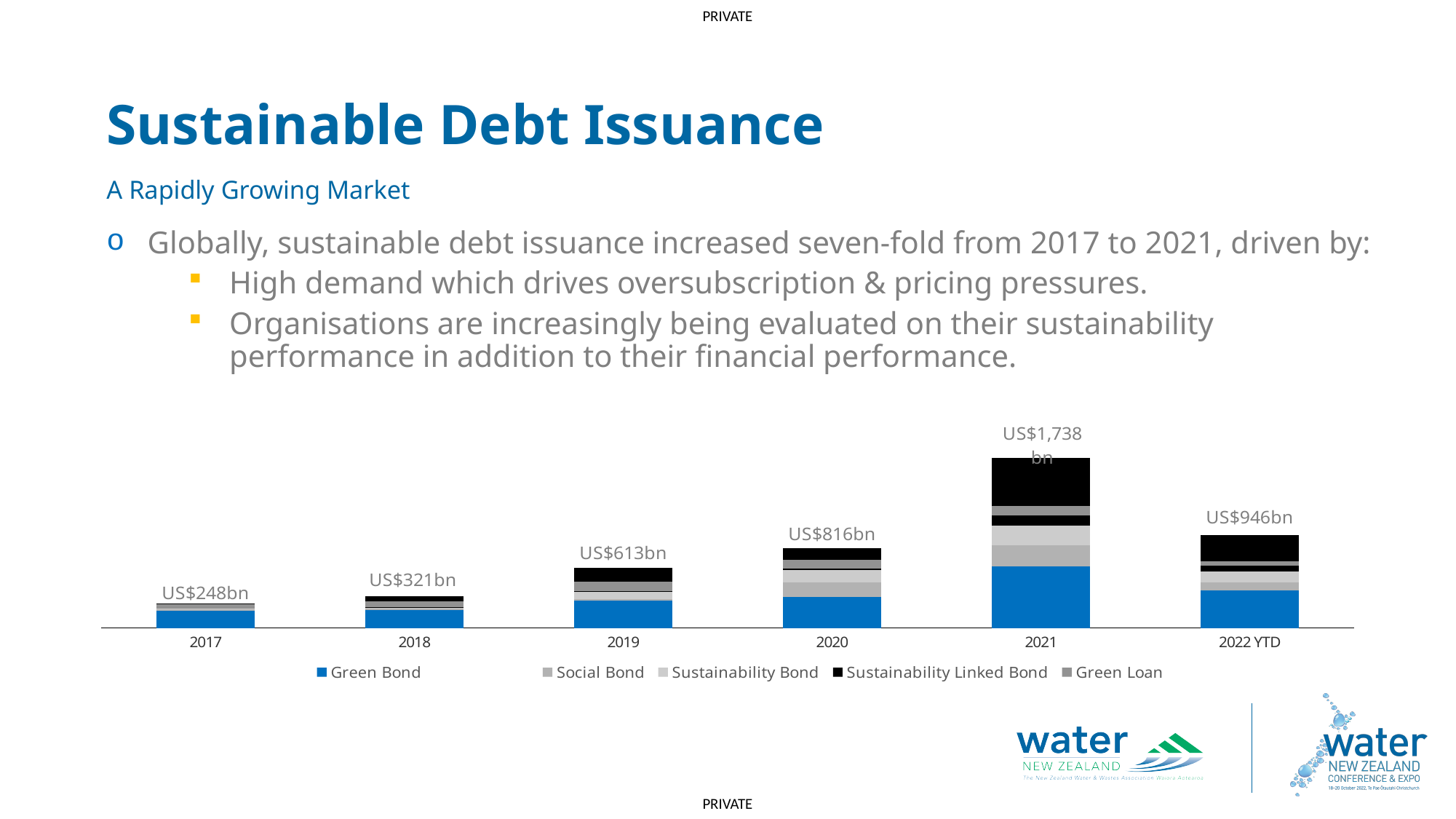
What is the total sustainable debt issuance shown for 2021? US$1,738bn Which is larger, the total issuance in 2018 or in 2020? 2020 What is the difference between the total issuance in 2021 and in 2022 YTD? US$792bn What is the difference between the total issuance in 2020 and in 2019? US$203bn Which year has the highest total sustainable debt issuance? 2021 What kind of chart is shown on the slide? Stacked bar chart What is the total sustainable debt issuance shown for 2017? US$248bn What is the total sustainable debt issuance shown for 2022 YTD? US$946bn How many years (categories) are shown on the x axis? 6 Which year has the lowest total sustainable debt issuance? 2017 How many series does the legend list? 5